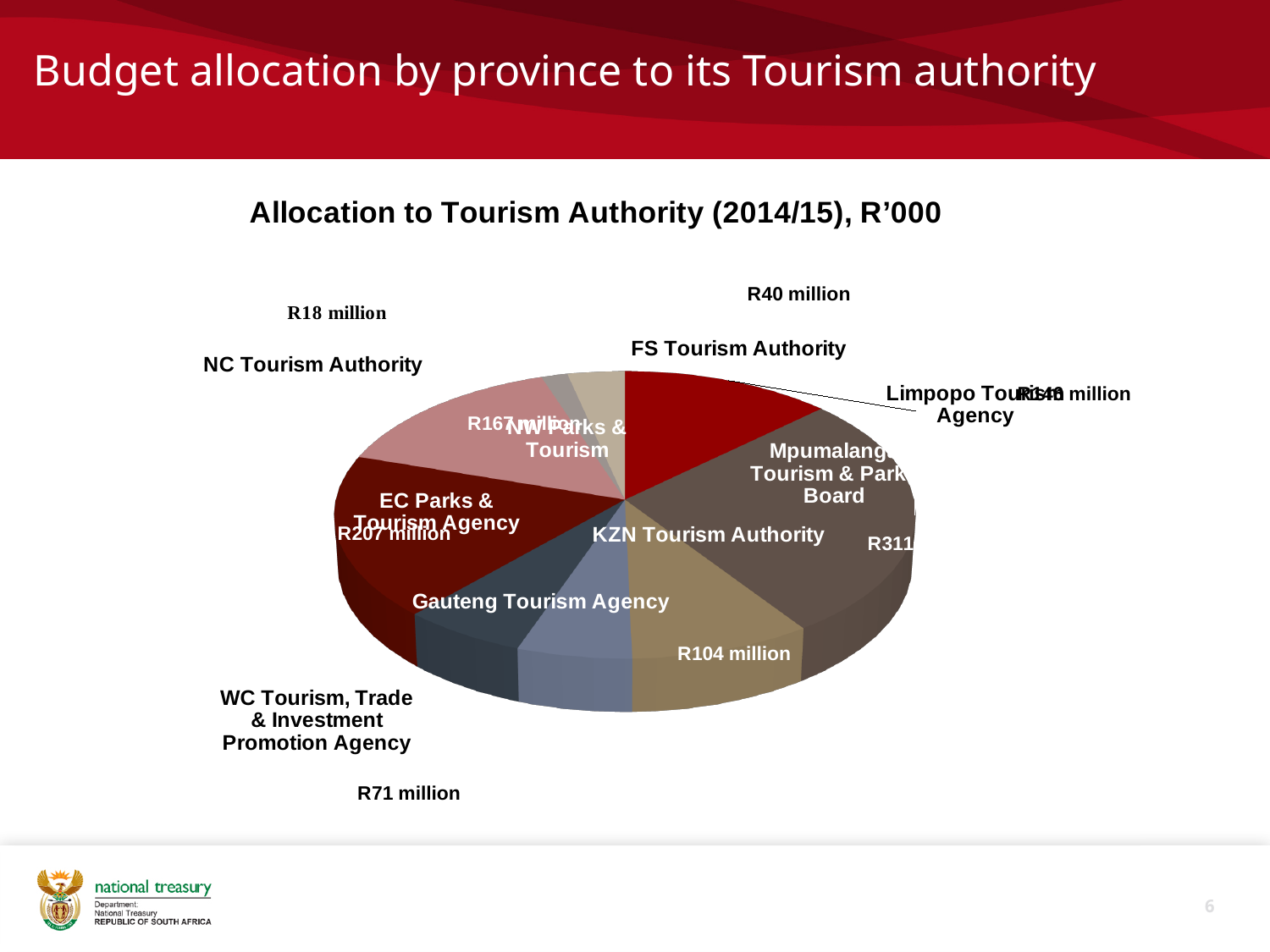
What is the allocation shown for the EC Parks & Tourism Agency? R207 million Which has the larger allocation, the EC Parks & Tourism Agency or the WC Tourism, Trade & Investment Promotion Agency? EC Parks & Tourism Agency What kind of chart is shown on the slide? Pie chart How many tourism authorities are labelled in the pie chart? 9 Which has the larger allocation, the FS Tourism Authority or the NC Tourism Authority? FS Tourism Authority How much larger is the allocation for the EC Parks & Tourism Agency than for the WC Tourism, Trade & Investment Promotion Agency? R136 million What is the allocation shown for the FS Tourism Authority? R40 million Which tourism authority has the smallest allocation in the pie chart? NC Tourism Authority What is the allocation shown for the NC Tourism Authority? R18 million What is the difference between the allocations for the FS Tourism Authority and the NC Tourism Authority? R22 million What is the title of the chart? Allocation to Tourism Authority (2014/15), R'000 What is the allocation shown for the WC Tourism, Trade & Investment Promotion Agency? R71 million